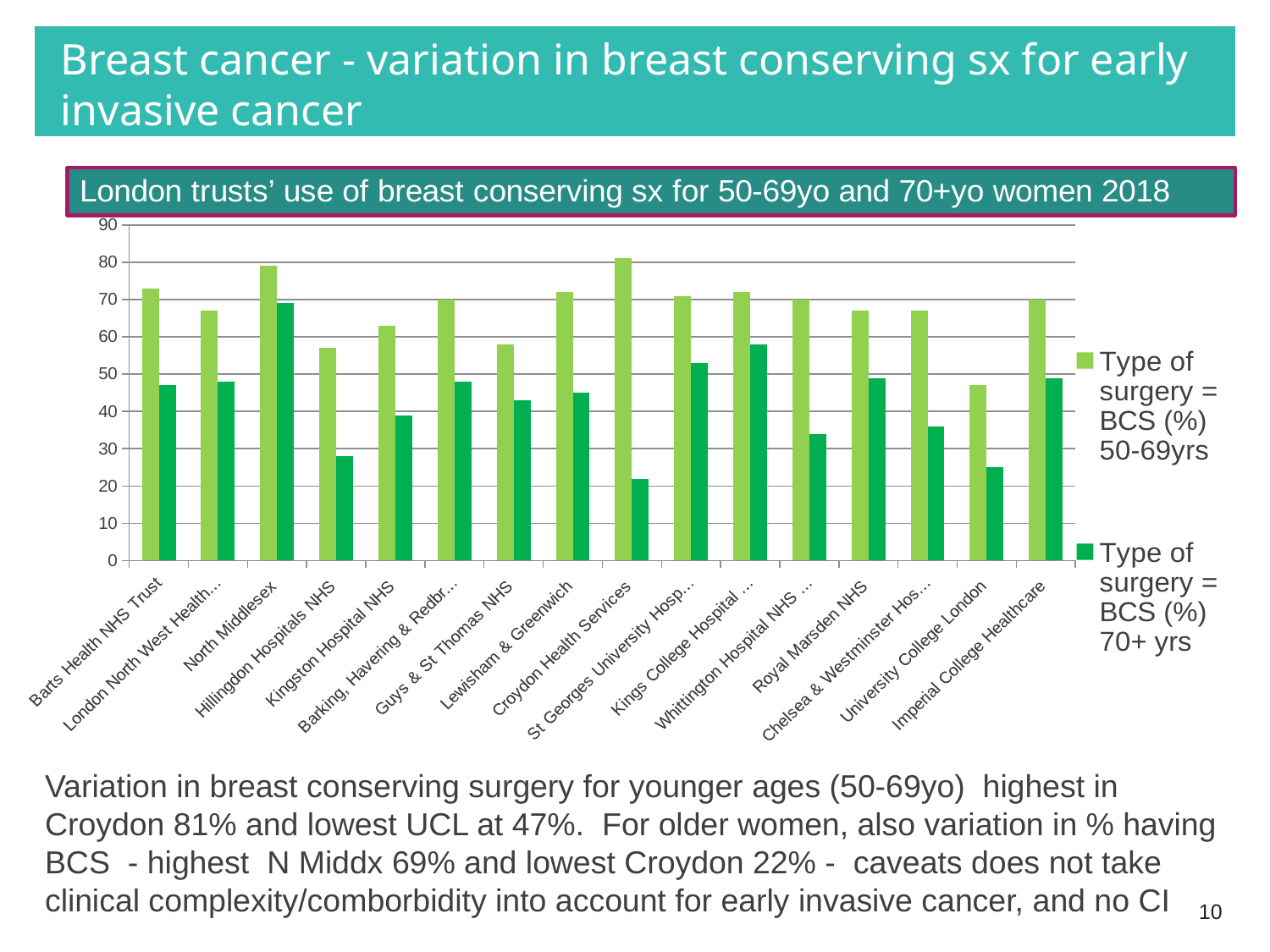
Which trust has the lowest value for Type of surgery = BCS (%) 50-69yrs? University College London Is the value for Type of surgery = BCS (%) 50-69yrs at North Middlesex greater or less than 70? greater What type of chart is shown on the slide? bar chart How many trusts are shown on the x axis of the chart? 16 What is the difference between the 50-69yrs and 70+ yrs BCS (%) values at Croydon Health Services? 59 Which trust has the highest value for Type of surgery = BCS (%) 70+ yrs? North Middlesex Which trust has the lowest value for Type of surgery = BCS (%) 70+ yrs? Croydon Health Services What is the BCS (%) value for 50-69yrs at Croydon Health Services? 81% Which trust has the highest value for Type of surgery = BCS (%) 50-69yrs? Croydon Health Services What is the BCS (%) value for 70+ yrs at North Middlesex? 69% Is the value for Type of surgery = BCS (%) 70+ yrs at Whittington Hospital NHS greater or less than 40? less How many series does the legend list? 2